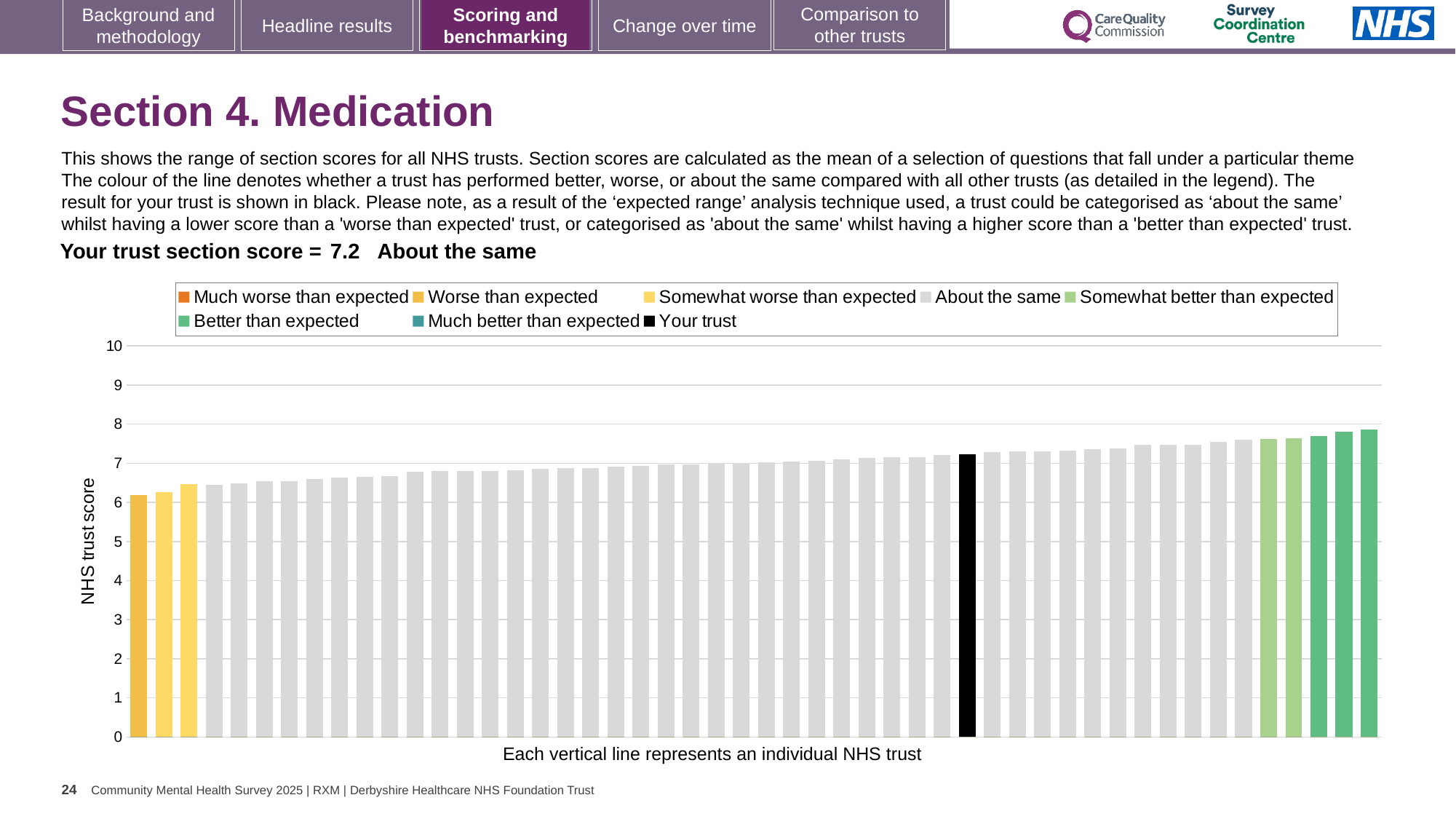
What kind of chart is shown on the slide? bar chart According to the slide, which category does your trust's section score fall into? About the same Is the value of the black 'Your trust' bar greater or less than 7? greater Is the value of the highest bar in the chart greater or less than 8? less How many entries does the chart legend list? 8 Is the value of the highest bar in the chart greater or less than 7? greater Which is larger: the value of the rightmost bar or the value of the black 'Your trust' bar? the rightmost bar What is the section score for your trust shown on the slide? 7.2 Which is larger: the value of the black 'Your trust' bar or the value of the leftmost bar? the black 'Your trust' bar What is the title of the vertical axis of the chart? NHS trust score Do the bar values rise or fall from left to right along the x axis? rise